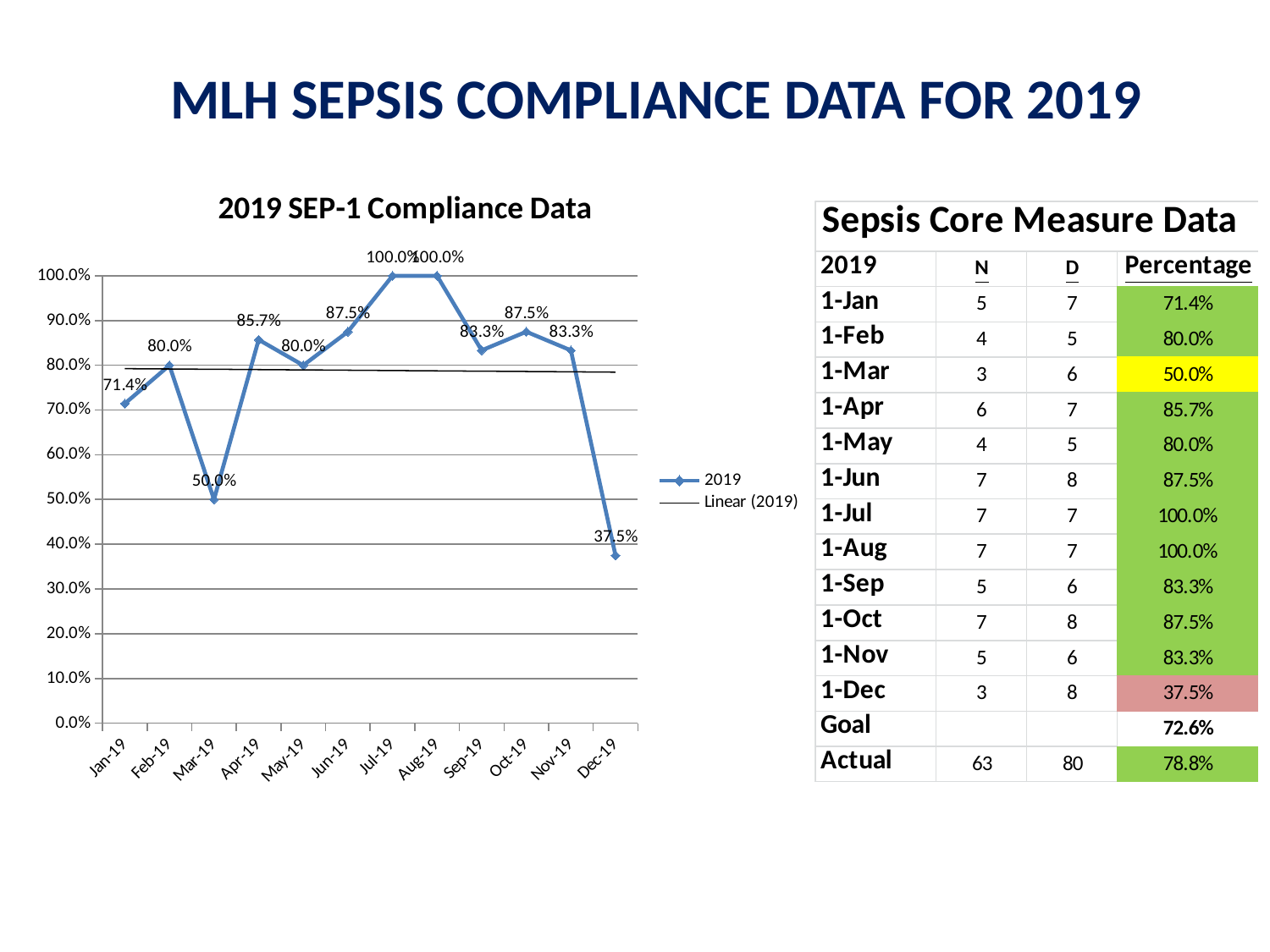
Does the value fall or rise from Nov-19 to Dec-19? fall What type of chart is shown? line chart What is the compliance value for Apr-19? 85.7% What is the compliance value for Dec-19? 37.5% How many months are plotted on the x axis? 12 What is the compliance value for Mar-19? 50.0% Which month has the lowest compliance value? Dec-19 How many entries does the legend list? 2 What is the difference between the values for Feb-19 and Mar-19? 30.0% Which is larger, the value for Sep-19 or the value for Oct-19? Oct-19 What is the title of the chart? 2019 SEP-1 Compliance Data What is the difference between the values for Jul-19 and Dec-19? 62.5%